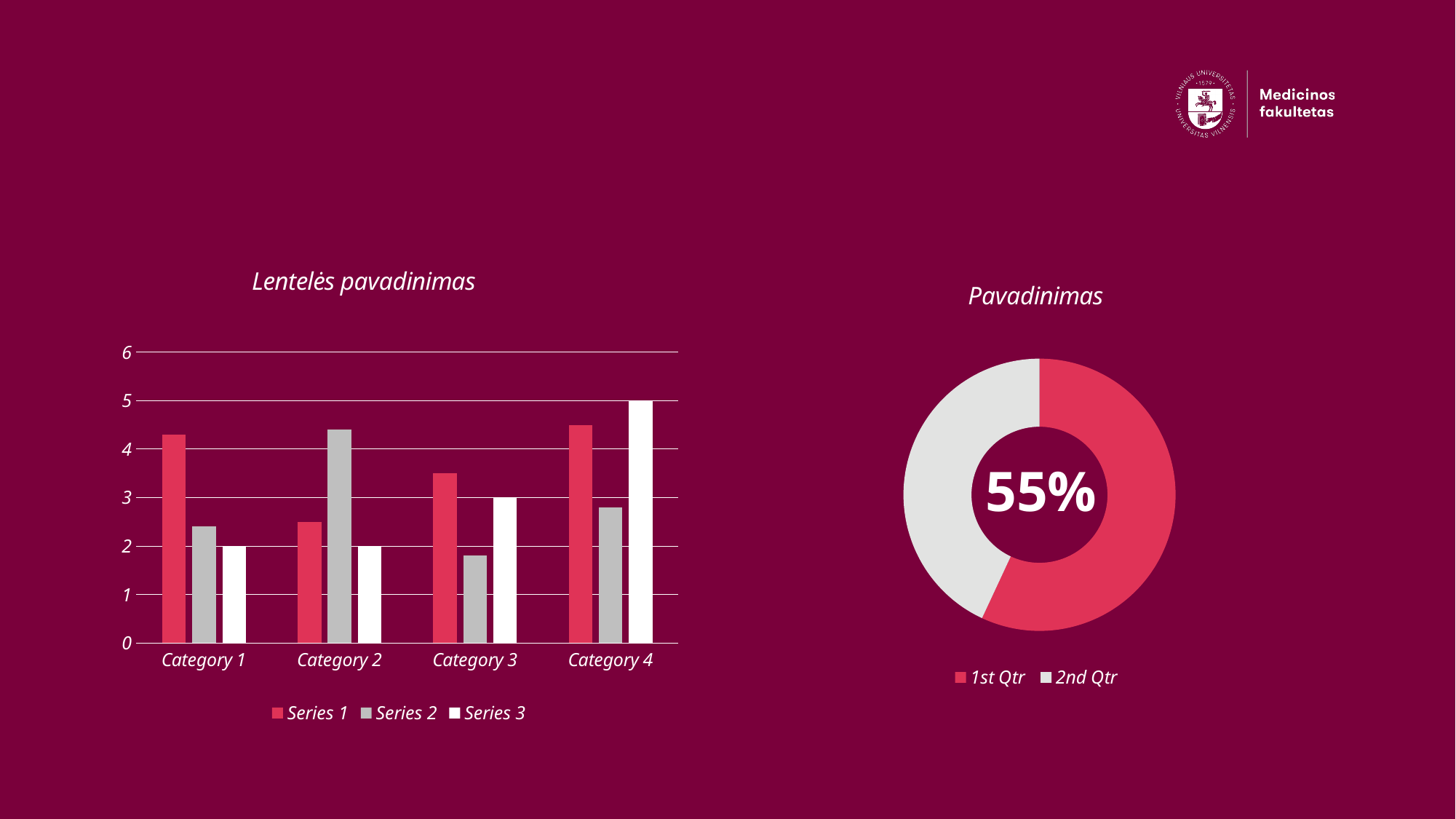
In the chart titled "Lentelės pavadinimas", what is the value of Series 3 for Category 1? 2 In the chart titled "Lentelės pavadinimas", which is larger for Category 2: Series 1 or Series 2? Series 2 How many series does the legend of the chart titled "Lentelės pavadinimas" list? 3 In the chart titled "Lentelės pavadinimas", what is the value of Series 3 for Category 3? 3 In the chart titled "Lentelės pavadinimas", is the value of Series 1 for Category 1 greater or less than 4? greater What type of chart is the chart titled "Lentelės pavadinimas"? Bar chart How many entries does the legend of the chart titled "Pavadinimas" list? 2 In the chart titled "Lentelės pavadinimas", what is the value of Series 3 for Category 4? 5 In the chart titled "Lentelės pavadinimas", which category has the lowest Series 2 value? Category 3 In the chart titled "Lentelės pavadinimas", which category has the highest Series 3 value? Category 4 How many categories are shown on the x axis of the chart titled "Lentelės pavadinimas"? 4